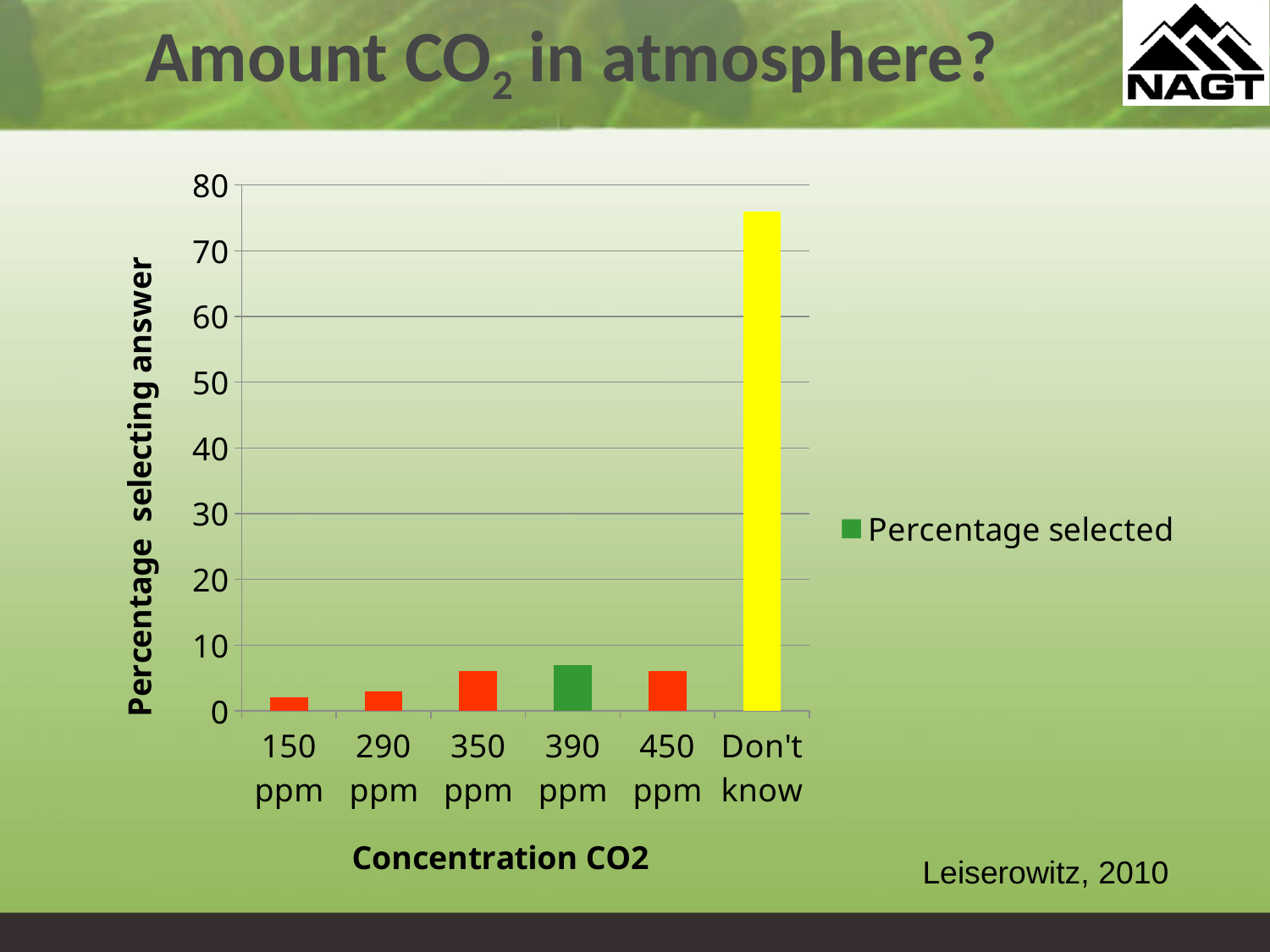
What is the title of the x axis? Concentration CO2 Which category has the highest percentage selecting answer? Don't know Is the value for Don't know greater or less than 70? greater What is the legend entry shown on the chart? Percentage selected How many categories are shown on the x axis? 6 Which is larger, the value for 350 ppm or the value for 150 ppm? 350 ppm Is the value for 390 ppm greater or less than 10? less How many series does the legend list? 1 Which is larger, the value for Don't know or the value for 390 ppm? Don't know Is the value for 150 ppm greater or less than 10? less What kind of chart is shown on the slide? bar chart